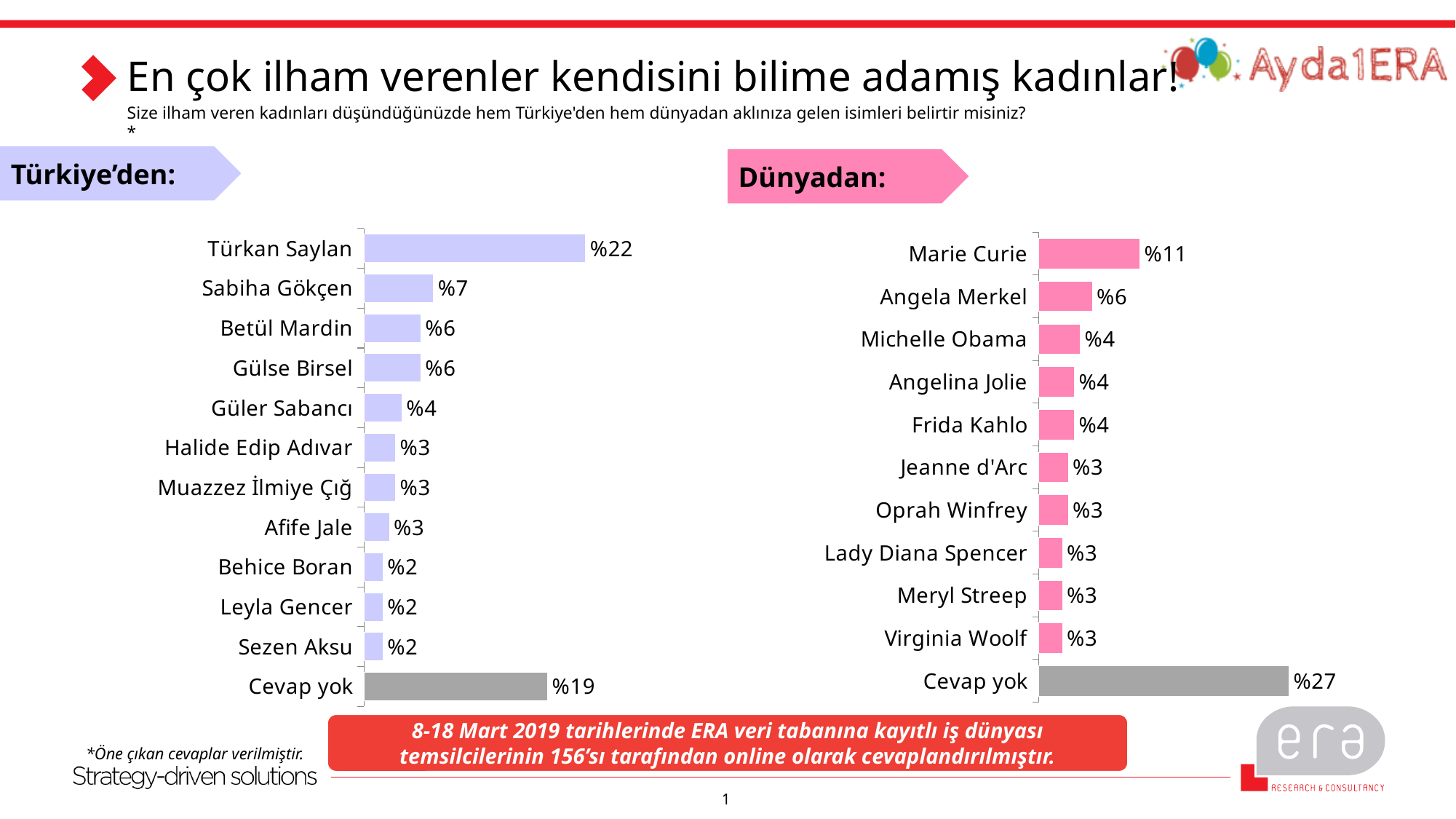
In the "Dünyadan" chart, what is the value for Marie Curie? %11 In the "Türkiye'den" chart, what is the difference between Türkan Saylan and Sabiha Gökçen? %15 In the "Türkiye'den" chart, what is the value for Türkan Saylan? %22 Which is larger: Cevap yok in the "Türkiye'den" chart or Cevap yok in the "Dünyadan" chart? Dünyadan In the "Türkiye'den" chart, what is the value for Sabiha Gökçen? %7 In the "Dünyadan" chart, what is the value for Cevap yok? %27 What type of chart is the "Dünyadan" chart? Bar chart In the "Dünyadan" chart, which named person has the highest value? Marie Curie How many categories (bars) does the "Dünyadan" chart show? 11 In the "Türkiye'den" chart, which named person has the highest value? Türkan Saylan In the "Dünyadan" chart, what is the difference between Marie Curie and Angela Merkel? %5 How many categories (bars) does the "Türkiye'den" chart show? 12